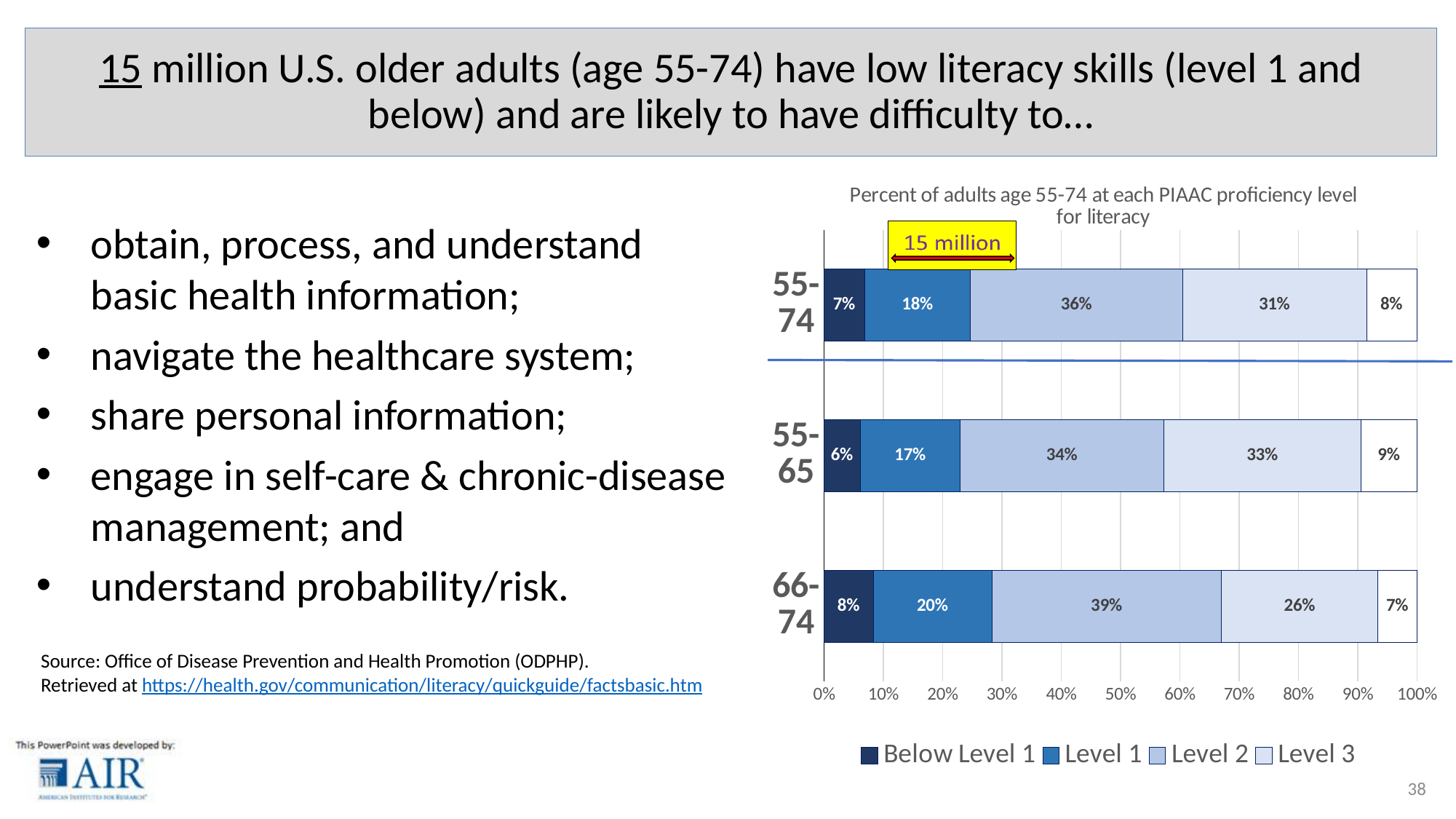
Which age group has the lowest Level 3 value? 66-74 What type of chart is shown on the slide? stacked bar chart What is the Level 1 value for the 55-65 age group? 17% What is the Level 3 value for the 55-65 age group? 33% How many age groups are shown in the chart? 3 What is the difference between the Level 1 values for the 66-74 and 55-65 age groups? 3% What is the Level 2 value for the 55-74 age group? 36% How many series does the legend list? 4 Which is larger, the Level 3 value for 55-65 or the Level 3 value for 55-74? 55-65 What is the title of the chart? Percent of adults age 55-74 at each PIAAC proficiency level for literacy Which age group has the highest Level 2 value? 66-74 What is the Below Level 1 value for the 66-74 age group? 8%